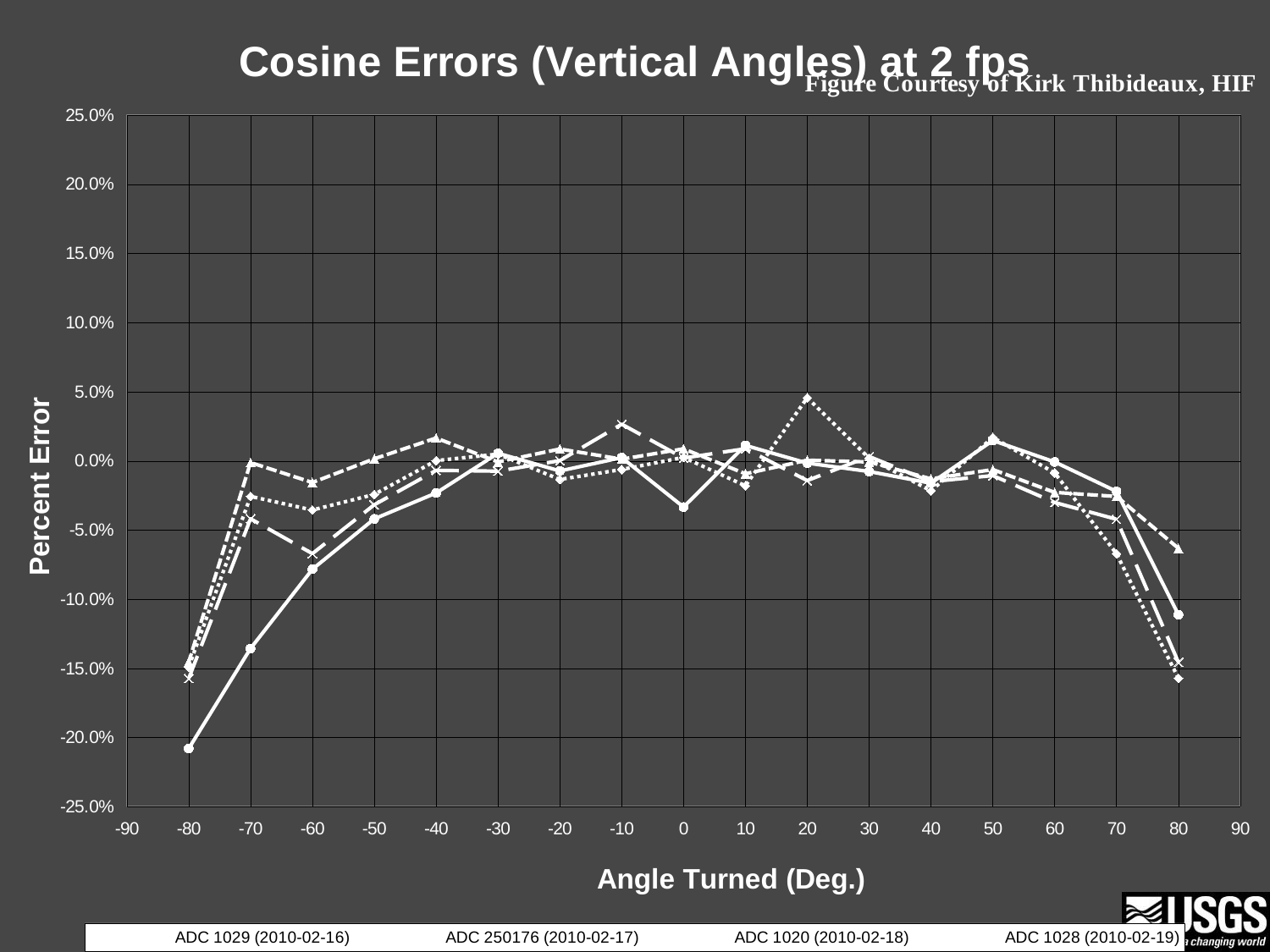
How many series does the legend list? 4 Between angles 50 and 80, do the plotted values generally rise or fall? fall Between angles -80 and -30, do the plotted values generally rise or fall? rise At which angle is the lowest value on the chart plotted? -80 Are all plotted values at an angle of 0 greater or less than 5.0%? less What is the title of the chart? Cosine Errors (Vertical Angles) at 2 fps What is the label of the x axis? Angle Turned (Deg.) Is the lowest plotted value on the chart greater or less than -20.0%? less How many angle values are plotted for each series (from -80 to 80)? 17 Is the highest plotted value on the chart greater or less than 10.0%? less What kind of chart is shown on the slide? line chart